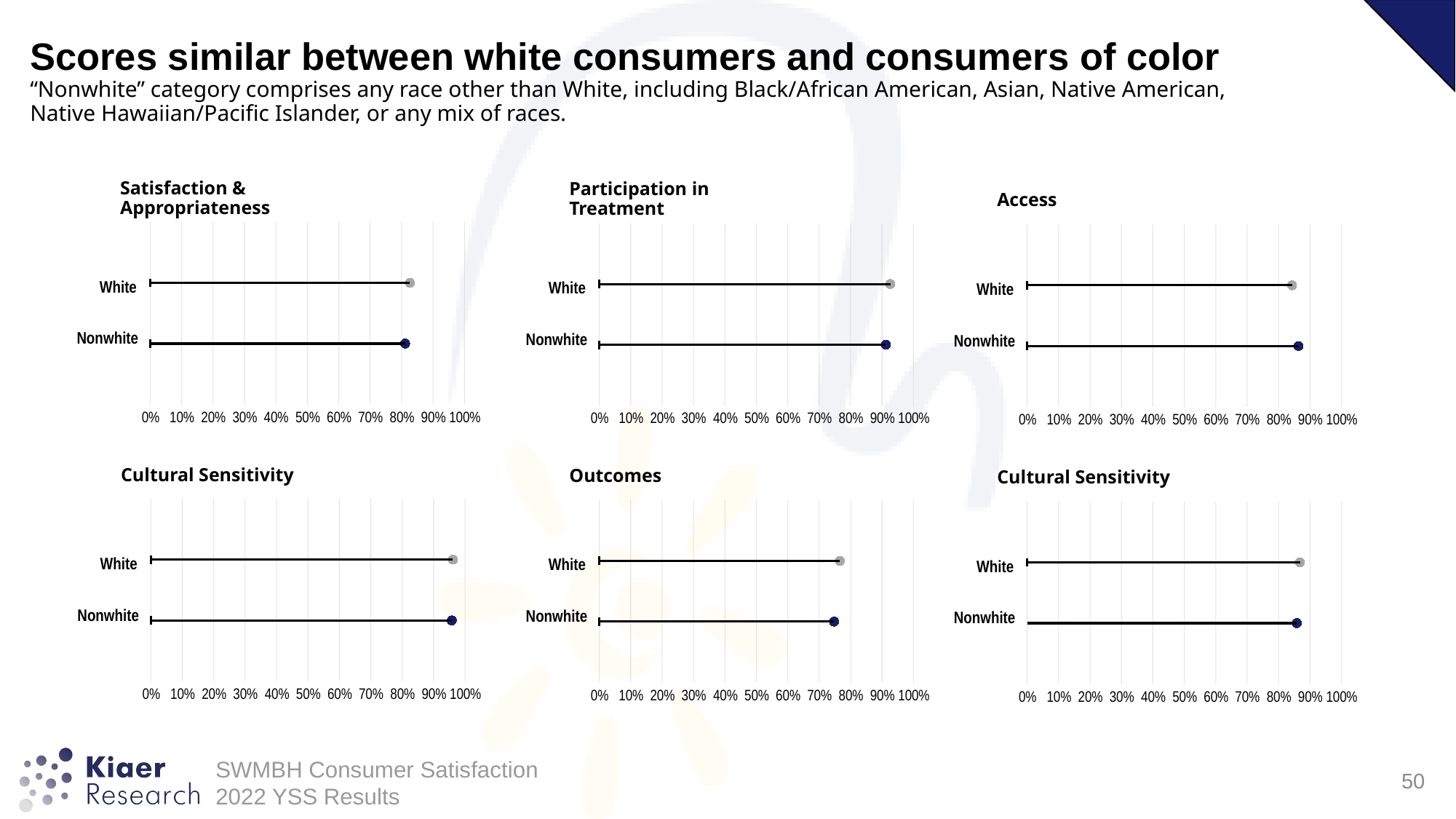
How many categories are plotted in the Access chart? 2 In the Participation in Treatment chart, is the value for Nonwhite greater or less than 80%? greater How many charts are shown on the slide? 6 What is the maximum value shown on the x axis of the Outcomes chart? 100% In the Participation in Treatment chart, is the value for White greater or less than 80%? greater In the Outcomes chart, is the value for Nonwhite greater or less than 80%? less